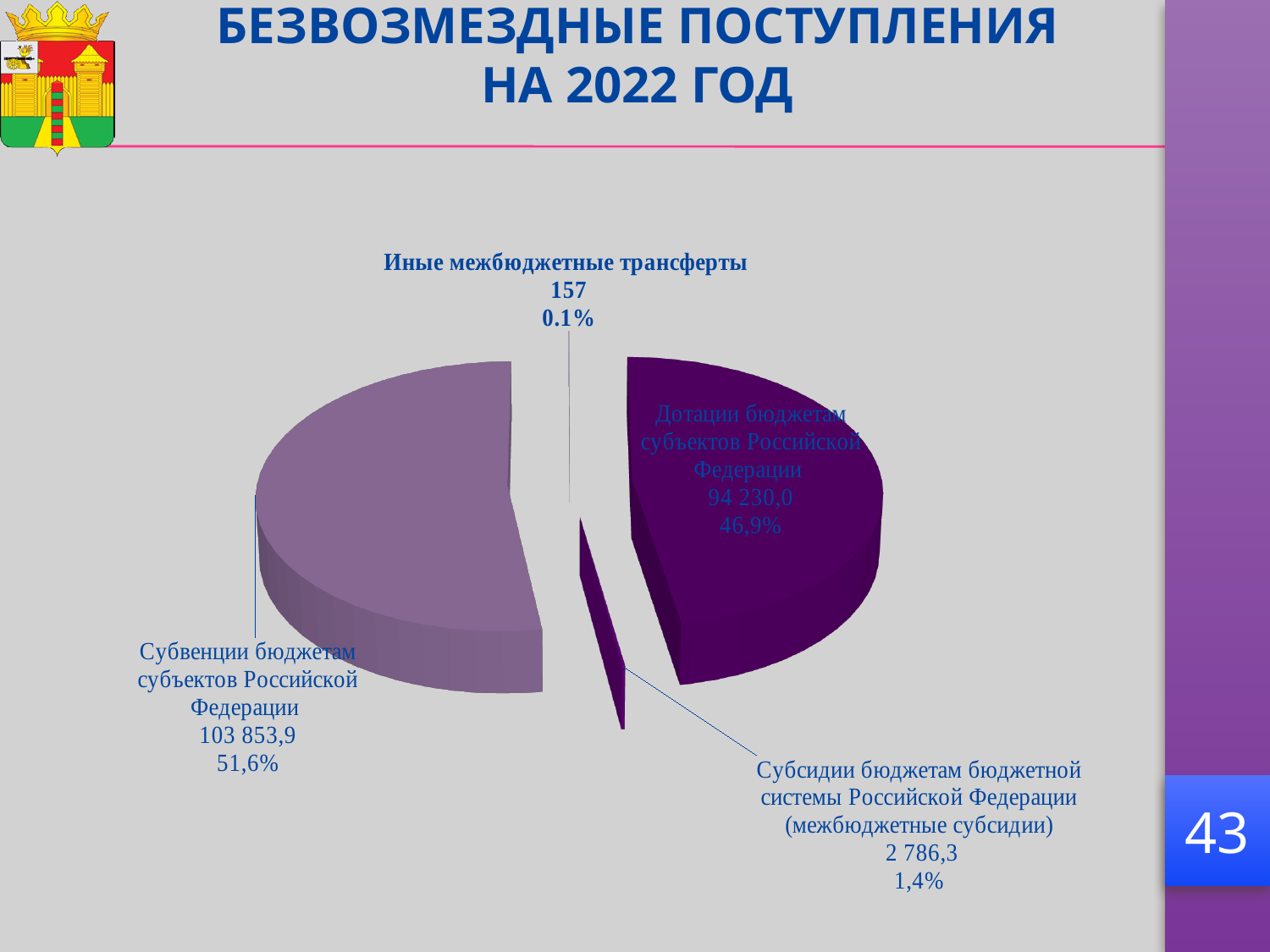
What share of the pie does Дотации бюджетам субъектов Российской Федерации represent? 46,9% What value is shown for Субвенции бюджетам субъектов Российской Федерации? 103 853,9 What share of the pie does Иные межбюджетные трансферты represent? 0.1% What value is shown for Иные межбюджетные трансферты? 157 How many categories are shown in the pie chart? 4 Which is larger: Дотации бюджетам субъектов Российской Федерации or Субсидии бюджетам бюджетной системы Российской Федерации (межбюджетные субсидии)? Дотации бюджетам субъектов Российской Федерации What value is shown for Субсидии бюджетам бюджетной системы Российской Федерации (межбюджетные субсидии)? 2 786,3 What value is shown for Дотации бюджетам субъектов Российской Федерации? 94 230,0 Which category has the smallest slice of the pie? Иные межбюджетные трансферты Which category has the largest slice of the pie? Субвенции бюджетам субъектов Российской Федерации What share of the pie does Субвенции бюджетам субъектов Российской Федерации represent? 51,6% What kind of chart is shown on the slide? Pie chart